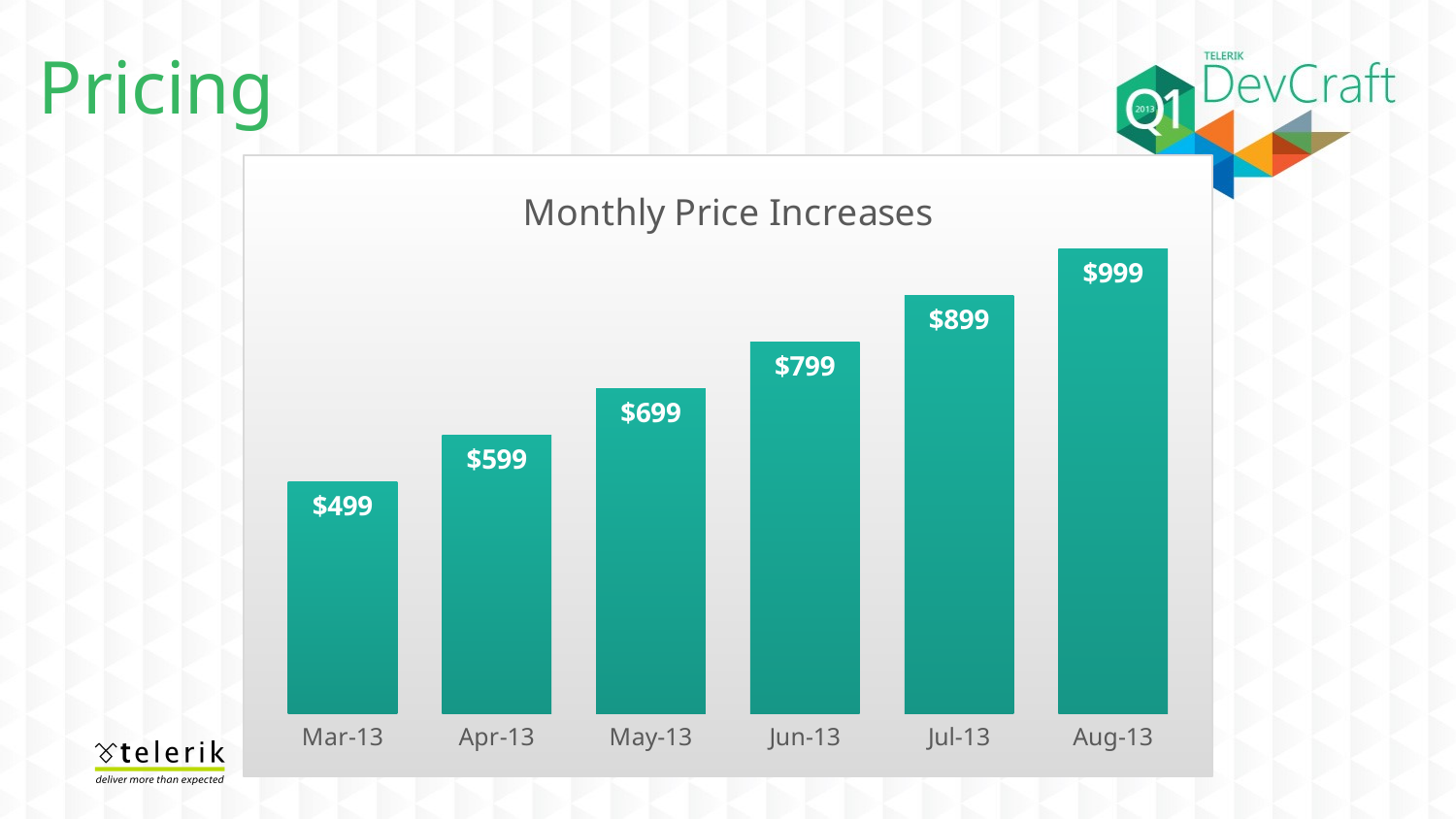
What is the difference between the values for Aug-13 and Mar-13? $500 What is the title of the chart? Monthly Price Increases What is the difference between the values for Jul-13 and May-13? $200 How many months are shown on the chart? 6 Which is larger, the value for Apr-13 or the value for Jun-13? Jun-13 What is the value for Mar-13? $499 What kind of chart is shown? bar chart Which month has the lowest value? Mar-13 What is the value for Jun-13? $799 Do the values rise or fall from Mar-13 to Aug-13? rise Which month has the highest value? Aug-13 What is the value for Aug-13? $999